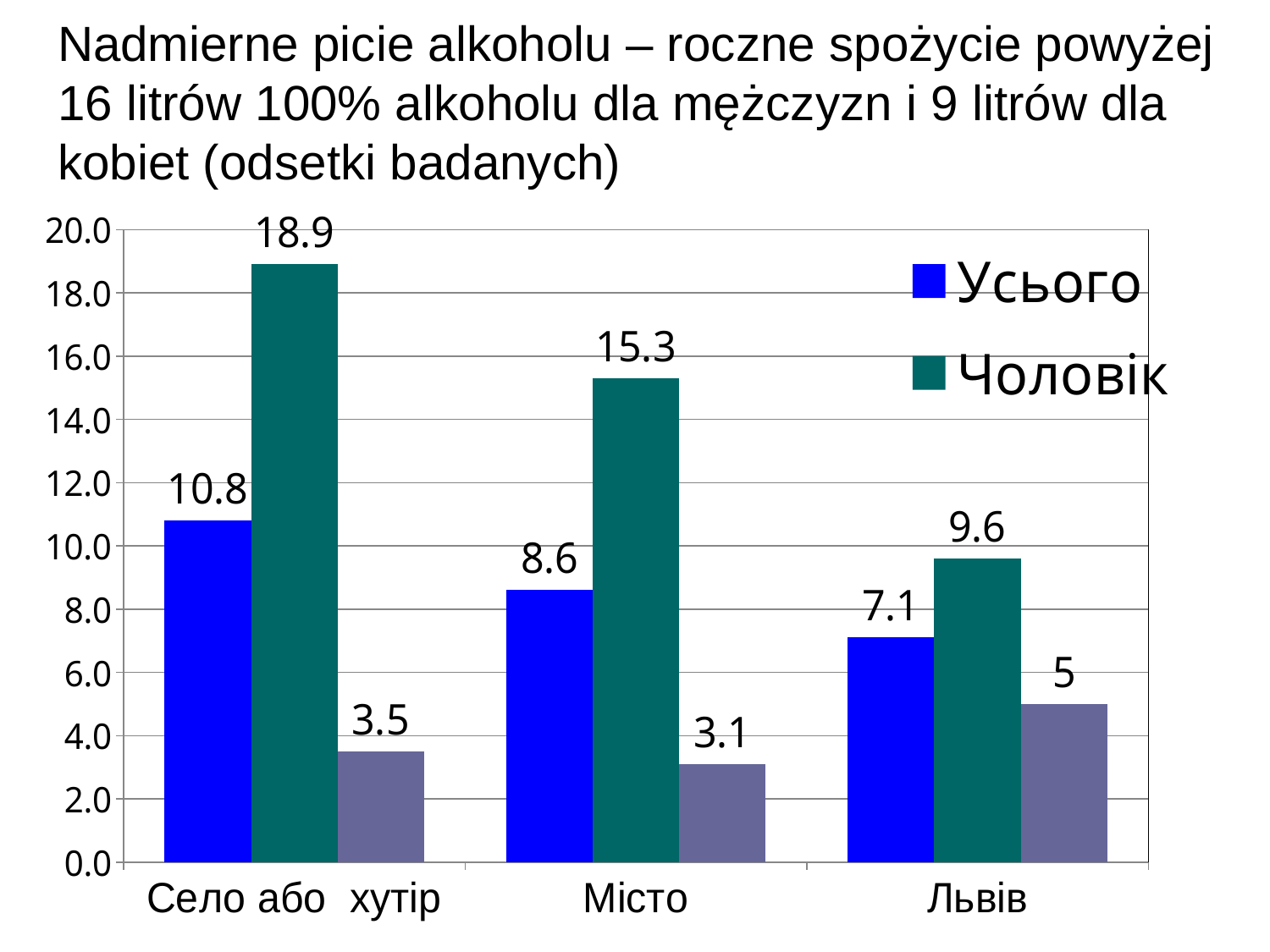
Which is larger: the Усього value for Місто or the Усього value for Львів? Місто What colour are the bars for the Чоловік series? teal (dark green) Which category has the lowest value for Усього? Львів What is the difference between the Чоловік and Усього values in the Село або хутір category? 8.1 What is the value for Усього in the Львів category? 7.1 What is the value for Усього in the Село або хутір category? 10.8 Do the Усього values rise or fall from Село або хутір to Львів? fall How many series does the legend list? 2 Which category has the highest value for Чоловік? Село або хутір What kind of chart is shown on the slide? bar chart What is the value for Чоловік in the Місто category? 15.3 How many categories are shown on the x axis? 3